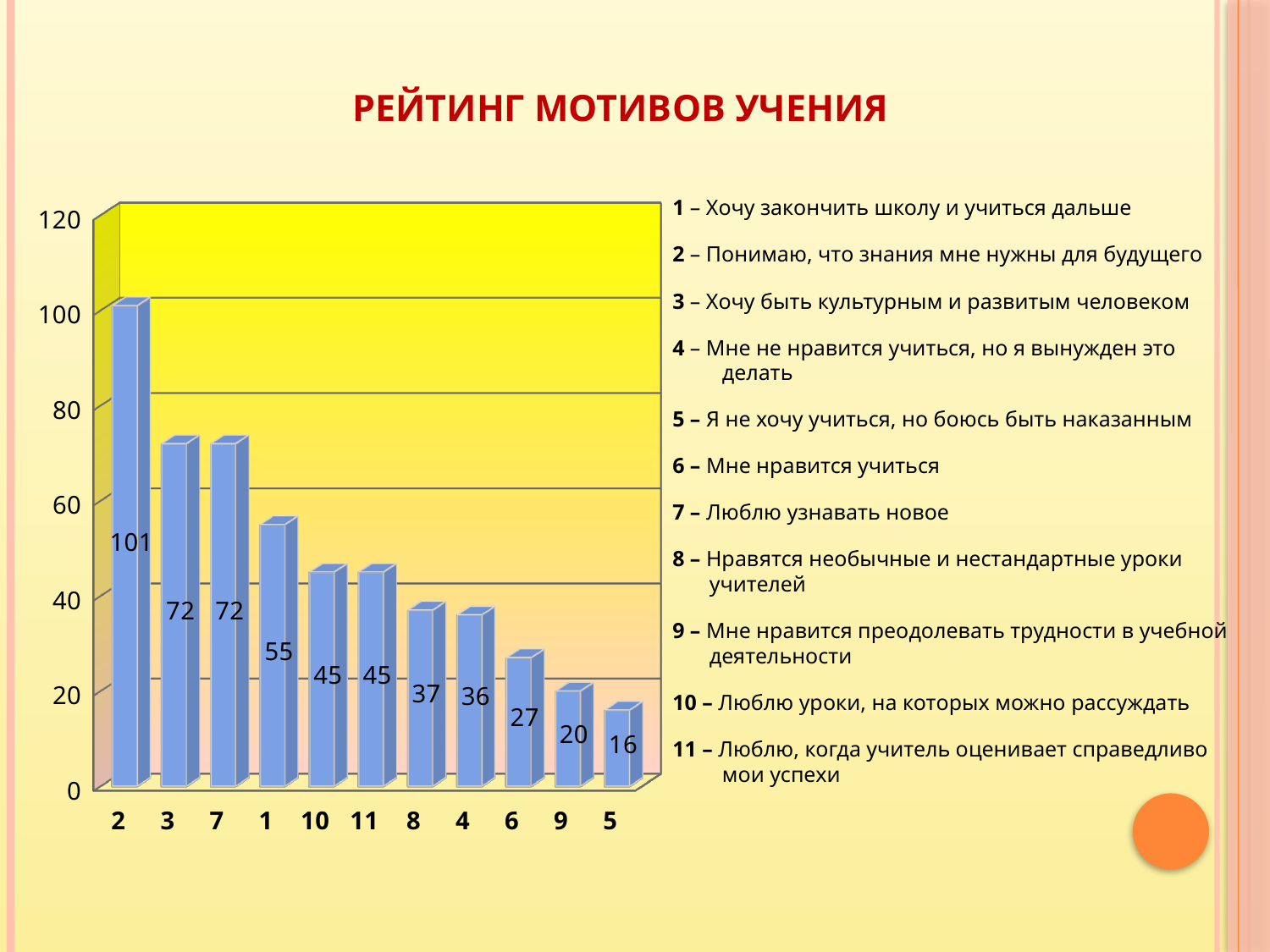
Do the values rise or fall from left to right along the x axis? fall What kind of chart is shown on the slide? bar chart Which is larger, the value for category 1 or the value for category 6? category 1 What is the value for category 10? 45 Is the value for category 9 greater or less than 40? less Which category has the lowest value? 5 What is the difference between the values for category 8 and category 4? 1 Which category has the highest value? 2 How many categories are shown on the x axis? 11 What is the value for category 2? 101 What is the value for category 5? 16 What is the difference between the values for category 2 and category 3? 29